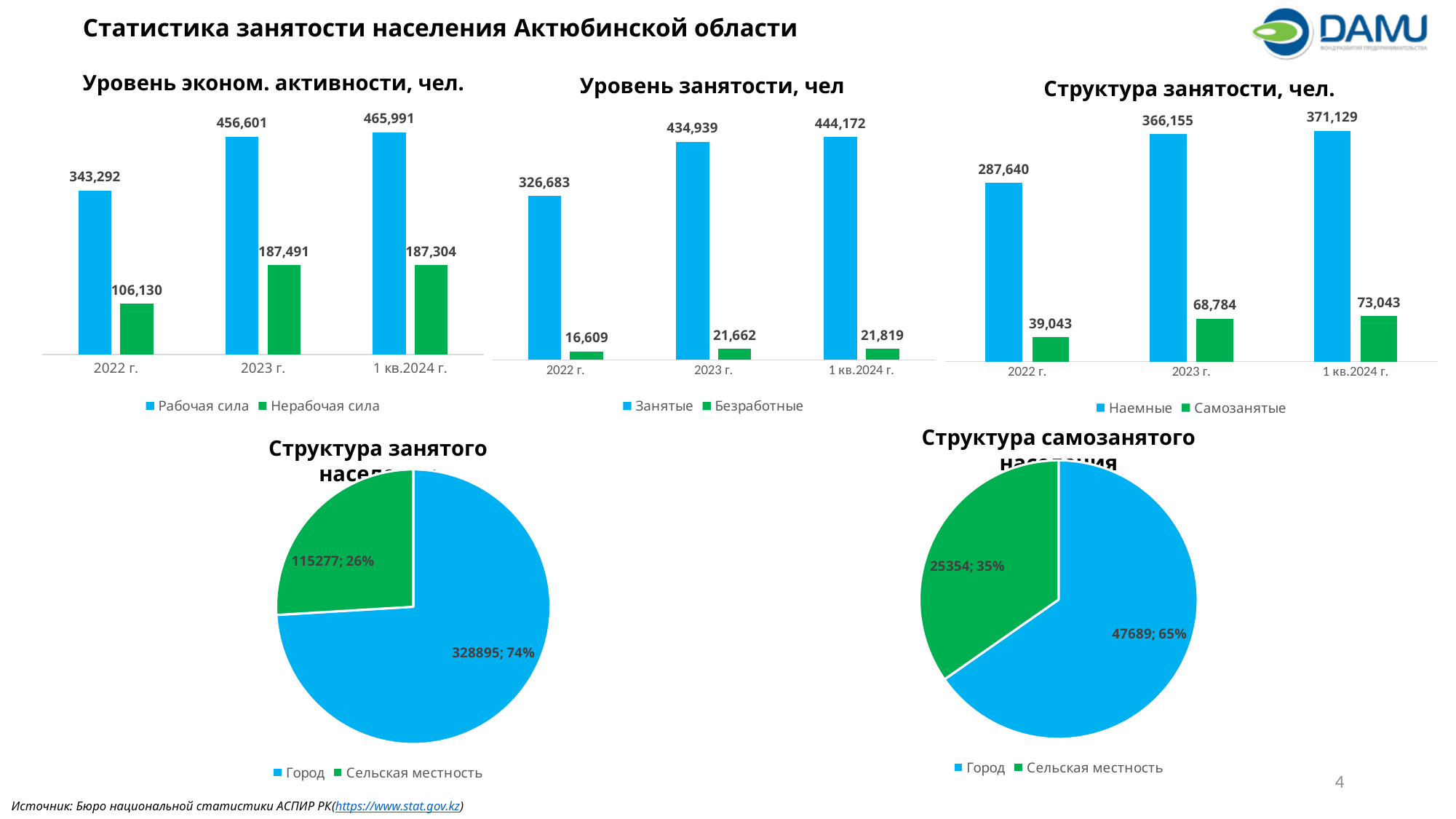
In the pie chart 'Структура самозанятого населения', what is the value for Город? 47689 What kind of chart is 'Структура самозанятого населения'? pie chart In the chart 'Уровень эконом. активности, чел.', what is the value of Нерабочая сила for 2022 г.? 106,130 In the chart 'Уровень эконом. активности, чел.', by how much did Рабочая сила increase from 2022 г. to 2023 г.? 113,309 In the chart 'Уровень занятости, чел', in which period is the value of Занятые the lowest? 2022 г. In the chart 'Структура занятости, чел.', what is the difference between Наемные in 1 кв.2024 г. and in 2023 г.? 4,974 In the chart 'Уровень эконом. активности, чел.', what is the value of Рабочая сила for 2023 г.? 456,601 In the chart 'Уровень занятости, чел', what is the value of Безработные for 1 кв.2024 г.? 21,819 In the chart 'Структура занятости, чел.', what is the value of Самозанятые for 2023 г.? 68,784 In the pie chart 'Структура занятого населения', what share does Сельская местность have? 26% In the chart 'Структура занятости, чел.', how many series does the legend list? 2 In the chart 'Уровень занятости, чел', does the value of Занятые rise or fall from 2022 г. to 1 кв.2024 г.? rise